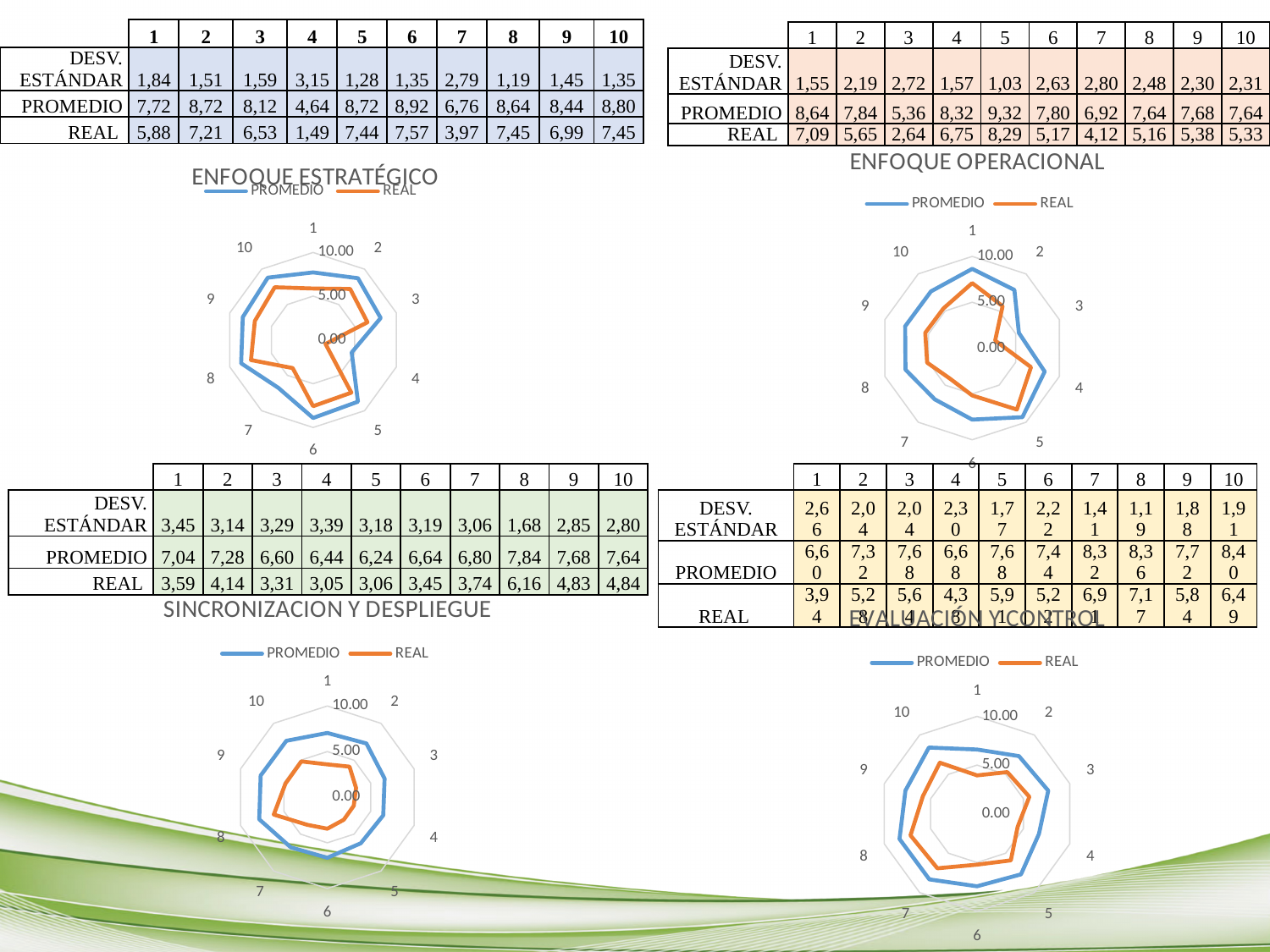
In the ENFOQUE OPERACIONAL chart, what is the REAL value for category 3? 2,64 In the SINCRONIZACION Y DESPLIEGUE chart, is the REAL value for category 4 greater or less than 5.00? less How many categories are plotted around the SINCRONIZACION Y DESPLIEGUE radar chart? 10 In the EVALUACIÓN Y CONTROL chart, which series has the larger value for category 10, PROMEDIO or REAL? PROMEDIO In the ENFOQUE ESTRATÉGICO chart, which category has the lowest REAL value? 4 In the ENFOQUE OPERACIONAL chart, which category has the highest PROMEDIO value? 5 In the EVALUACIÓN Y CONTROL chart, which category has the highest REAL value? 8 What kind of chart is the ENFOQUE ESTRATÉGICO chart? Radar chart In the SINCRONIZACION Y DESPLIEGUE chart, what is the difference between the PROMEDIO and REAL values for category 8? 1,68 What are the two legend entries shown on the ENFOQUE ESTRATÉGICO chart? PROMEDIO and REAL How many series does the legend of the ENFOQUE OPERACIONAL chart list? 2 In the ENFOQUE ESTRATÉGICO chart, what is the REAL value for category 4? 1,49